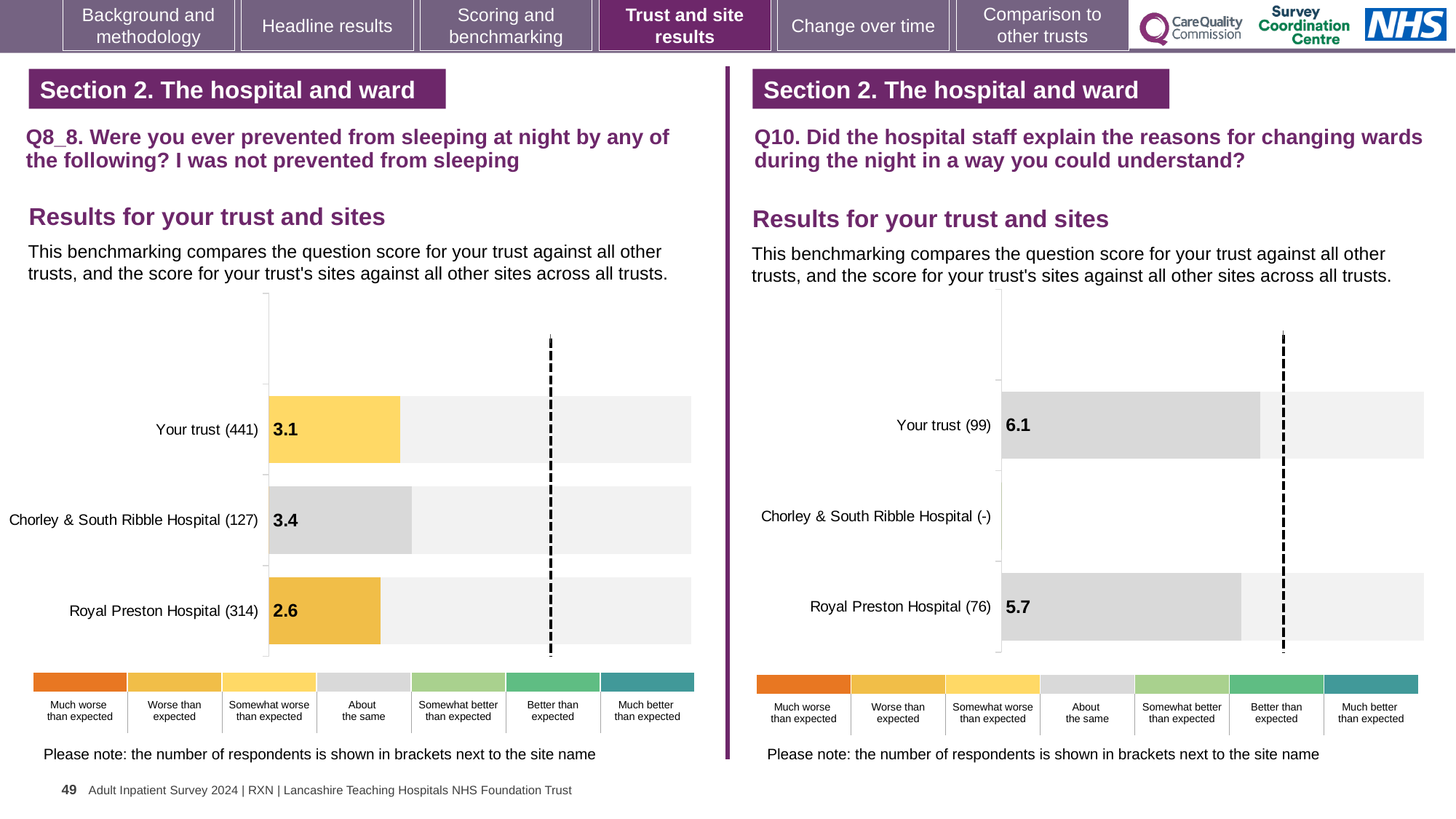
In the Q10 chart on the right, what is the difference between the scores for Your trust and Royal Preston Hospital? 0.4 What kind of chart is used on the left for Q8_8? Bar chart In the Q10 chart on the right, what is the score for Royal Preston Hospital? 5.7 In the Q8_8 chart on the left, what is the difference between the scores for Chorley & South Ribble Hospital and Royal Preston Hospital? 0.8 How many bars are labelled in the Q8_8 chart on the left? 3 In the Q10 chart on the right, which is larger, the score for Your trust or for Royal Preston Hospital? Your trust In the Q8_8 chart on the left, how many respondents are shown in brackets for Your trust? 441 In the Q8_8 chart on the left, which site or trust has the lowest score? Royal Preston Hospital In the Q8_8 chart on the left, what is the score for Your trust? 3.1 In the Q10 chart on the right, what is the score for Your trust? 6.1 In the Q8_8 chart on the left, what is the score for Royal Preston Hospital? 2.6 In the Q8_8 chart on the left, which site or trust has the highest score? Chorley & South Ribble Hospital